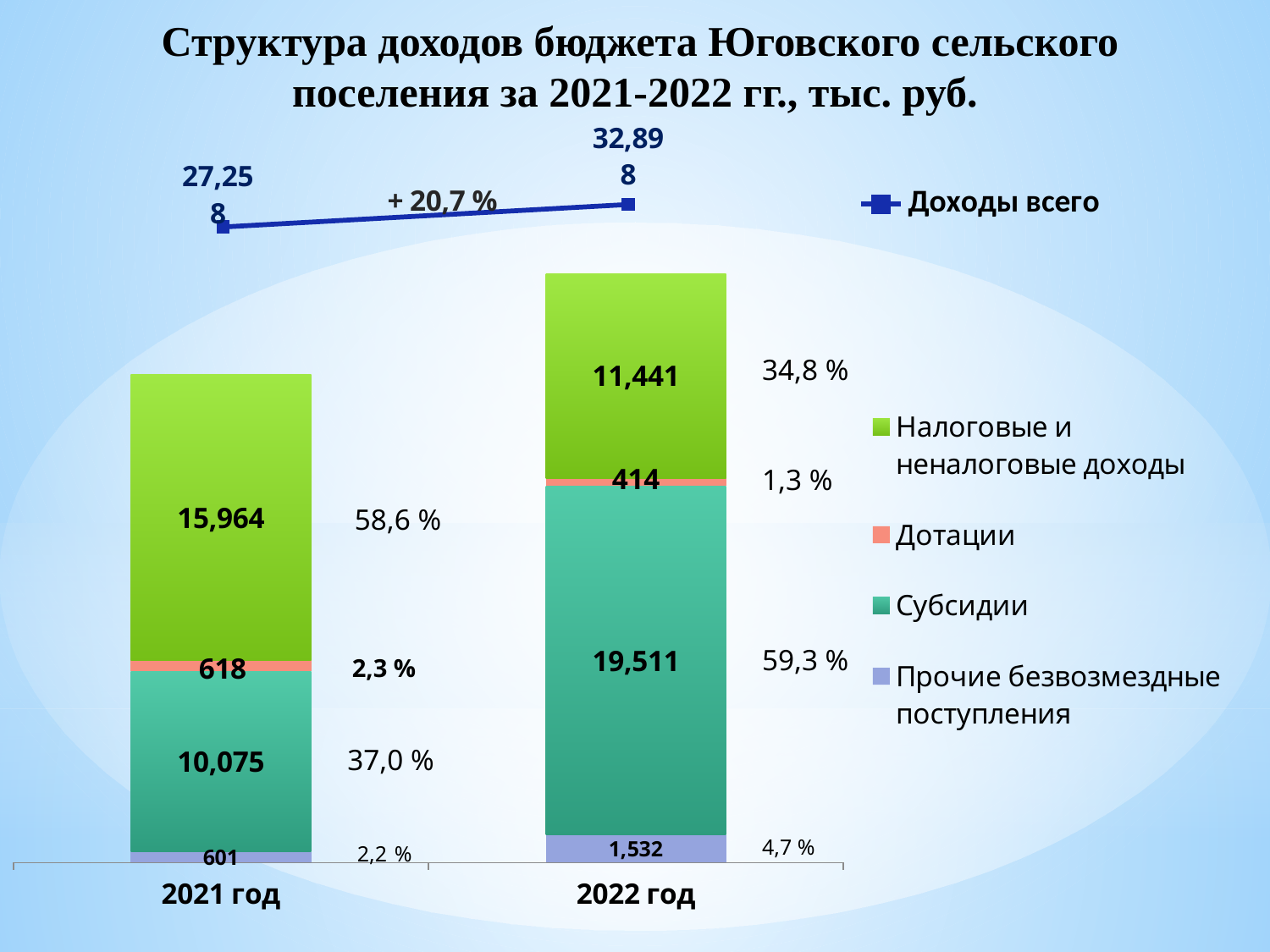
What is the value of Субсидии for 2022 год? 19,511 Which series has the largest value in the 2021 год bar? Налоговые и неналоговые доходы What percentage growth in Доходы всего is labelled between 2021 год and 2022 год? + 20,7 % What is the difference between the Субсидии values for 2022 год and 2021 год? 9,436 Which series has the smallest value in the 2022 год bar? Дотации Which is larger: Налоговые и неналоговые доходы in 2021 год or in 2022 год? 2021 год How many categories are shown on the x axis? 2 What is the Доходы всего value for 2022 год? 32,898 What is the value of Налоговые и неналоговые доходы for 2021 год? 15,964 What is the value of Прочие безвозмездные поступления for 2021 год? 601 What is the value of Дотации for 2022 год? 414